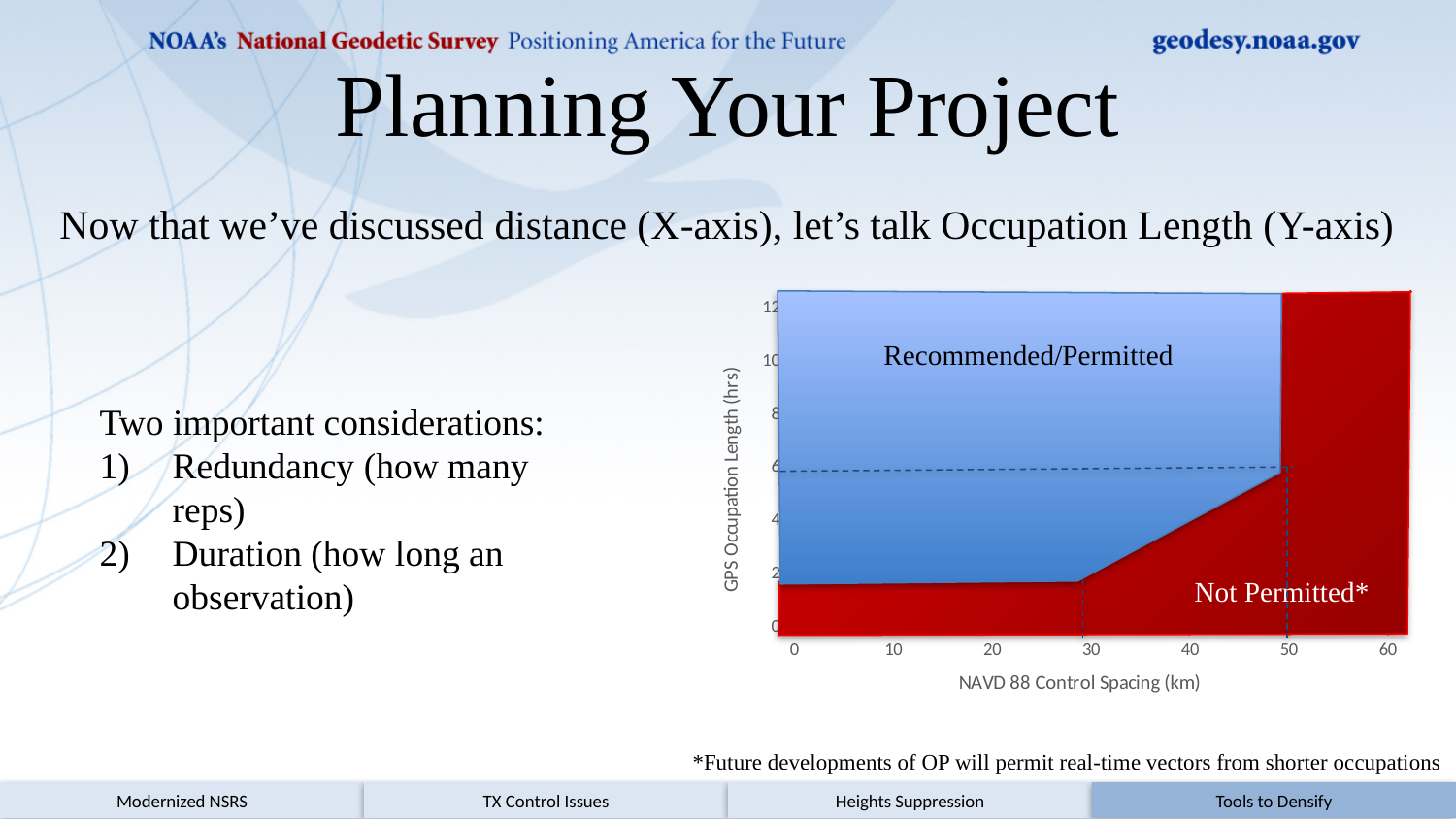
At what GPS occupation length does the dashed horizontal line sit? 6 At what NAVD 88 control spacing does the dashed vertical line mark the end of the permitted region? 50 Does the minimum permitted occupation length rise or fall as control spacing increases from 30 km to 50 km? rise What is the title of the y axis of the chart? GPS Occupation Length (hrs) At a control spacing of 10 km, is the lower boundary of the permitted region greater or less than 4 hrs? less What label is shown in the red region of the chart? Not Permitted* At a control spacing of 40 km, is the lower boundary of the permitted region greater or less than 2 hrs? greater What kind of chart is shown on the slide? area chart What is the highest value shown on the y axis of the chart? 12 What is the title of the x axis of the chart? NAVD 88 Control Spacing (km) What label is shown in the blue region of the chart? Recommended/Permitted What is the highest value shown on the x axis of the chart? 60